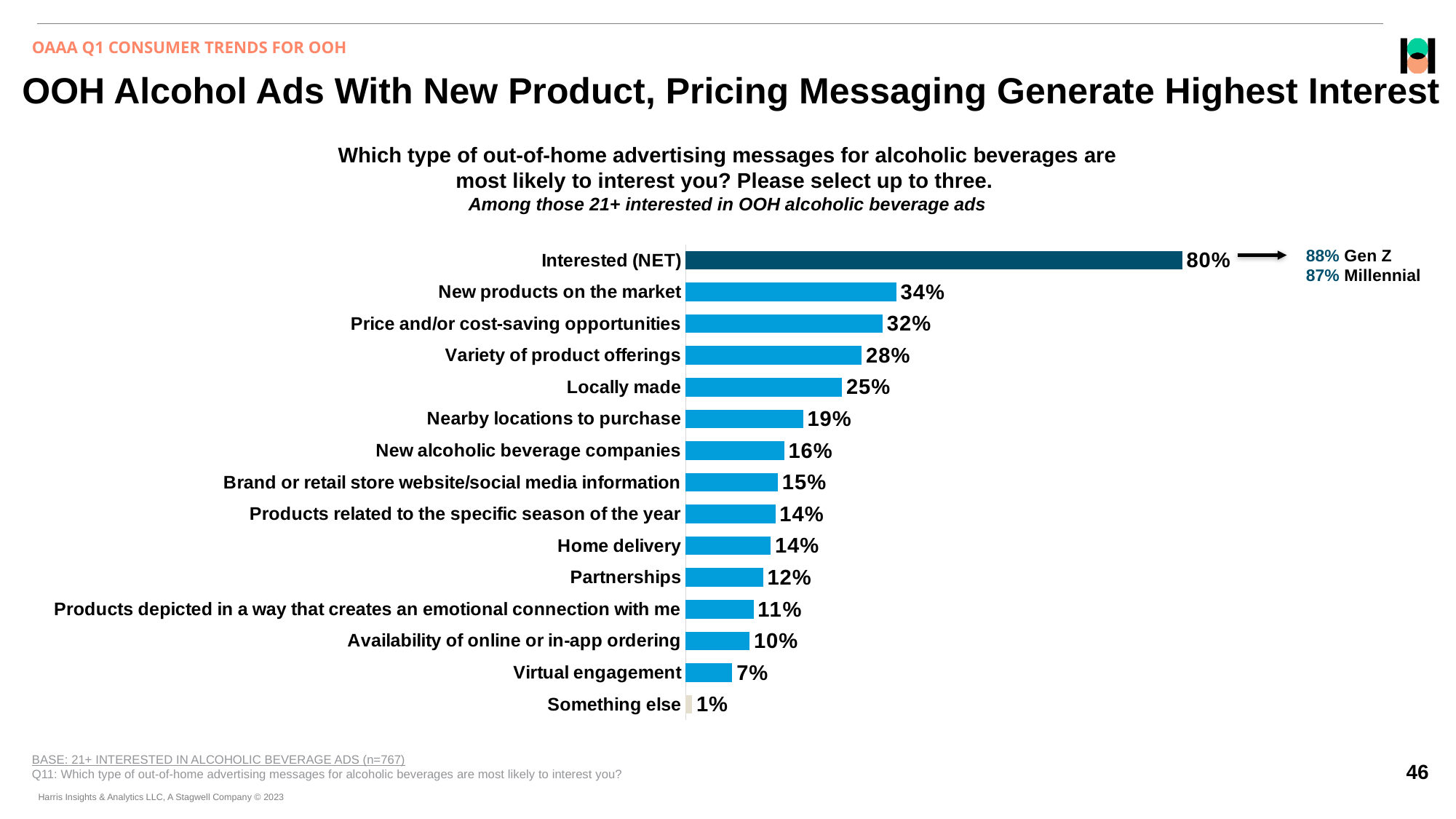
What percentage is shown for "Virtual engagement"? 7% Which category has the lowest value in the chart? Something else How many bars are plotted in the chart? 15 Which is larger: "Nearby locations to purchase" or "New alcoholic beverage companies"? Nearby locations to purchase What is the difference between "New products on the market" and "Price and/or cost-saving opportunities"? 2% What is the value for "Locally made"? 25% What percentage is shown for "New products on the market"? 34% What is the Interested (NET) percentage for Gen Z noted next to the chart? 88% What is the difference between "Variety of product offerings" and "Home delivery"? 14% What is the value for "Partnerships"? 12% Excluding the Interested (NET) bar, which message type has the highest value? New products on the market What kind of chart is shown on the slide? Bar chart